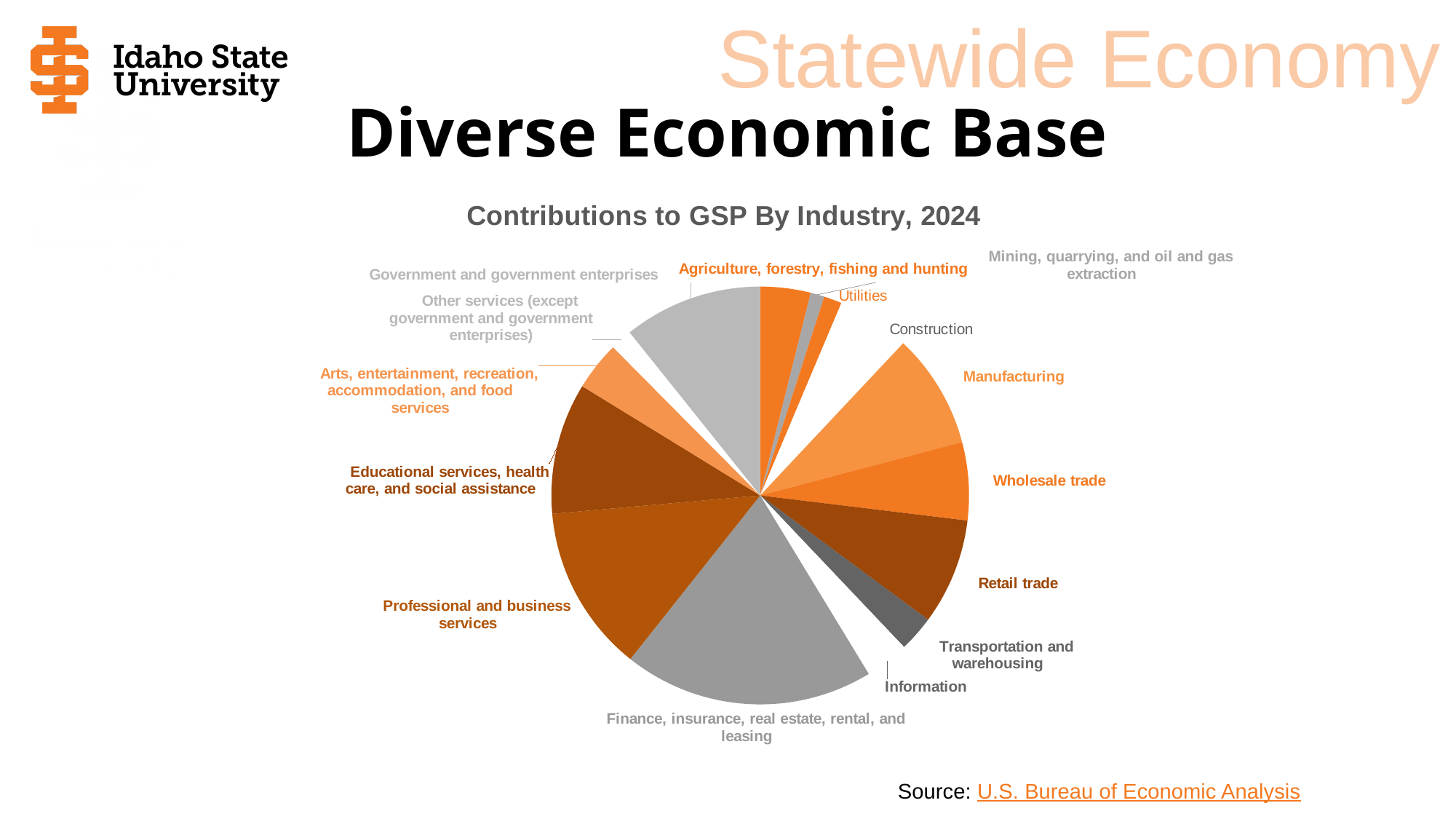
Which slice is larger: Manufacturing or Construction? Manufacturing What source is cited for the chart data? U.S. Bureau of Economic Analysis Which slice is larger: Professional and business services or Retail trade? Professional and business services What is the title of the chart? Contributions to GSP By Industry, 2024 Which industry has the largest slice of the pie chart? Finance, insurance, real estate, rental, and leasing What kind of chart is shown on the slide? Pie chart How many industry categories (slices) does the pie chart show? 15 Which slice is larger: Finance, insurance, real estate, rental, and leasing or Manufacturing? Finance, insurance, real estate, rental, and leasing